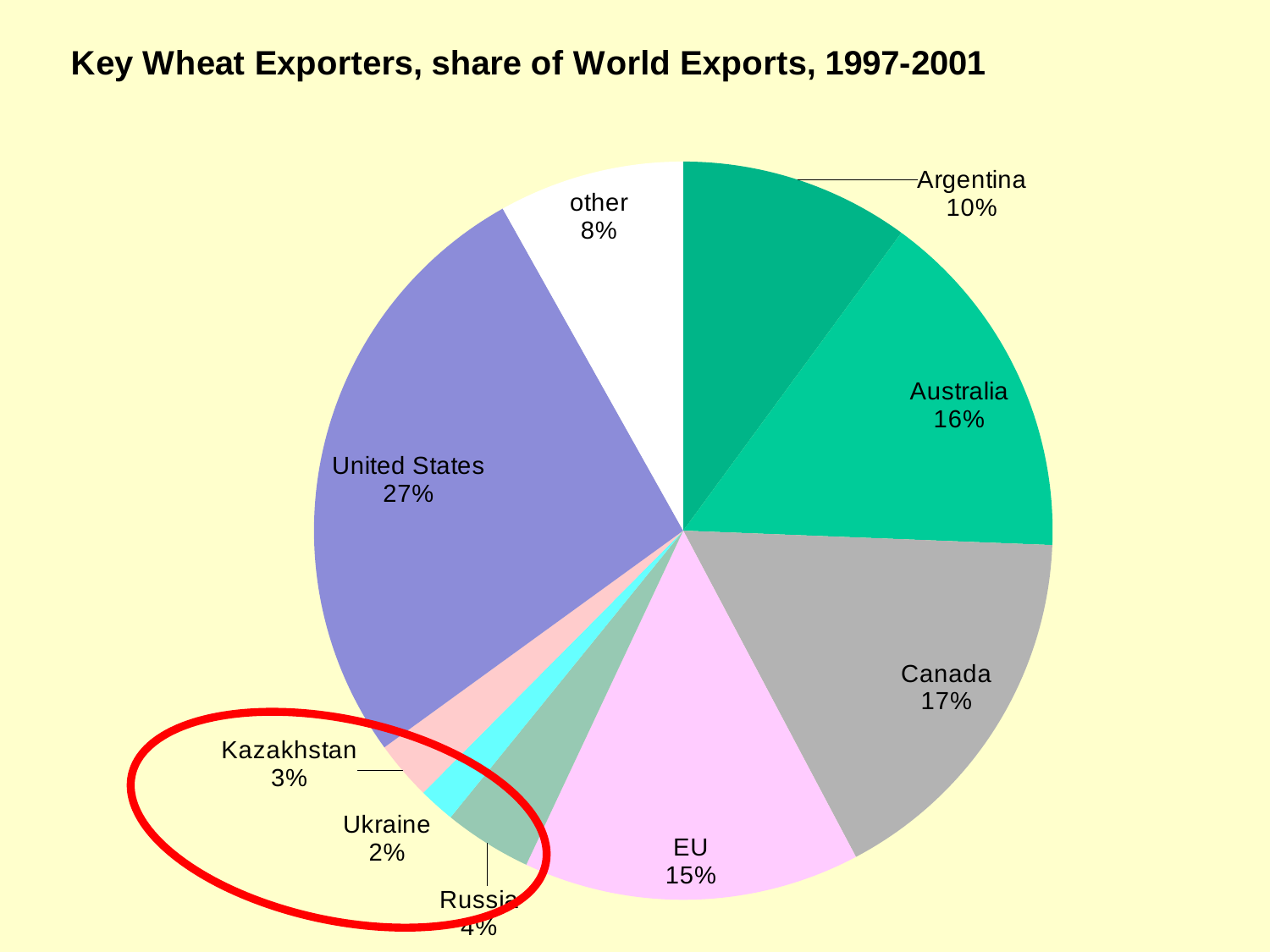
Which exporter has the smallest share of world wheat exports? Ukraine What kind of chart is shown on the slide? pie chart Which exporter has the largest share of world wheat exports? United States Which has a larger share of world wheat exports, Argentina or Australia? Australia What share of world wheat exports does the United States have? 27% What share of world wheat exports does Kazakhstan have? 3% Which three countries are circled in red on the chart? Kazakhstan, Ukraine, Russia What is the title of the chart? Key Wheat Exporters, share of World Exports, 1997-2001 What share of world wheat exports does Canada have? 17% What is the difference between the shares of the United States and the EU? 12% What share of world wheat exports does Australia have? 16% How many slices does the pie chart have? 9